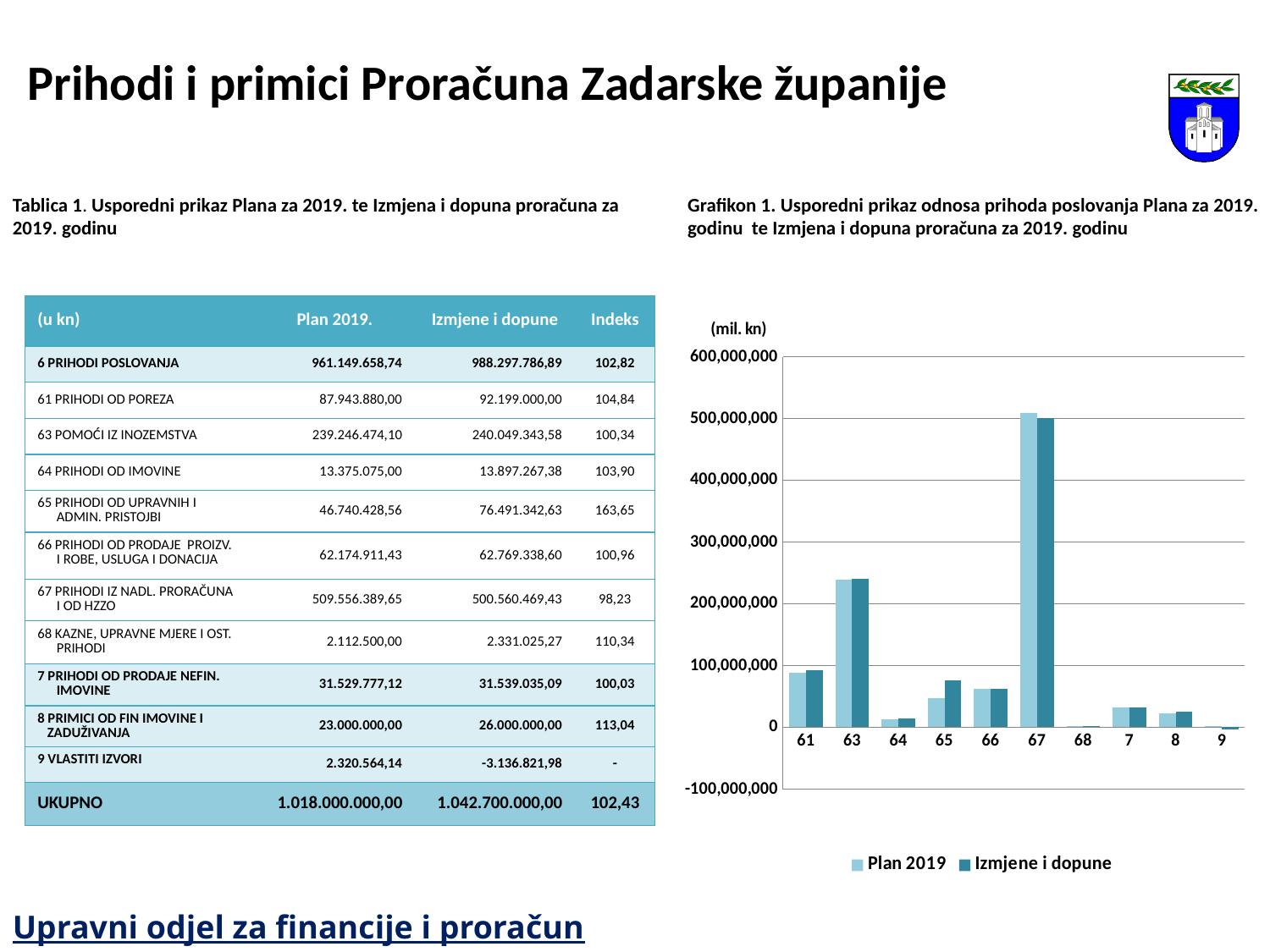
How many series does the chart legend list? 2 What are the two series named in the chart legend? Plan 2019 and Izmjene i dopune How many categories are shown along the x axis of the chart? 10 Which category has the highest bars in the chart? 67 Which category has the larger Plan 2019 bar, 63 or 65? 63 Is the Plan 2019 value for category 66 greater or less than 100,000,000? less What unit label is shown above the y axis of the chart? (mil. kn) Is the Plan 2019 value for category 67 greater or less than 400,000,000? greater Is the Plan 2019 value for category 63 greater or less than 200,000,000? greater Which category has the larger Izmjene i dopune bar, 61 or 64? 61 What kind of chart is shown on the slide? bar chart